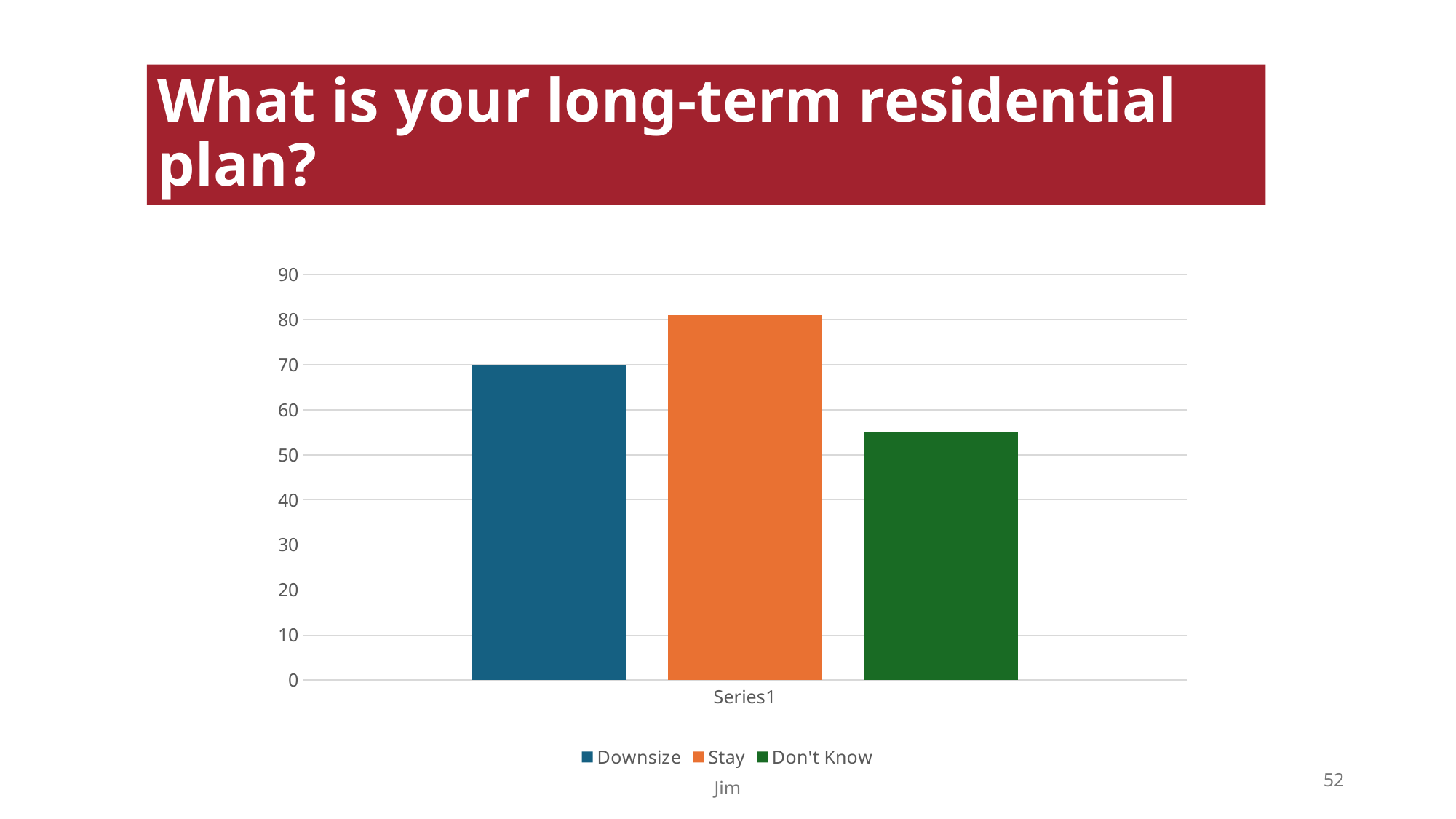
How many bars are plotted in the chart? 3 Which is larger, the Downsize bar or the Stay bar? Stay Which series has the tallest bar? Stay What colour is the Stay bar? orange What is the value of the Downsize bar? 70 Which series has the shortest bar? Don't Know How many series does the legend list? 3 Is the value for Don't Know greater or less than 50? greater Which is larger, the Downsize bar or the Don't Know bar? Downsize Is the value for Don't Know greater or less than 60? less What type of chart is shown on the slide? bar chart